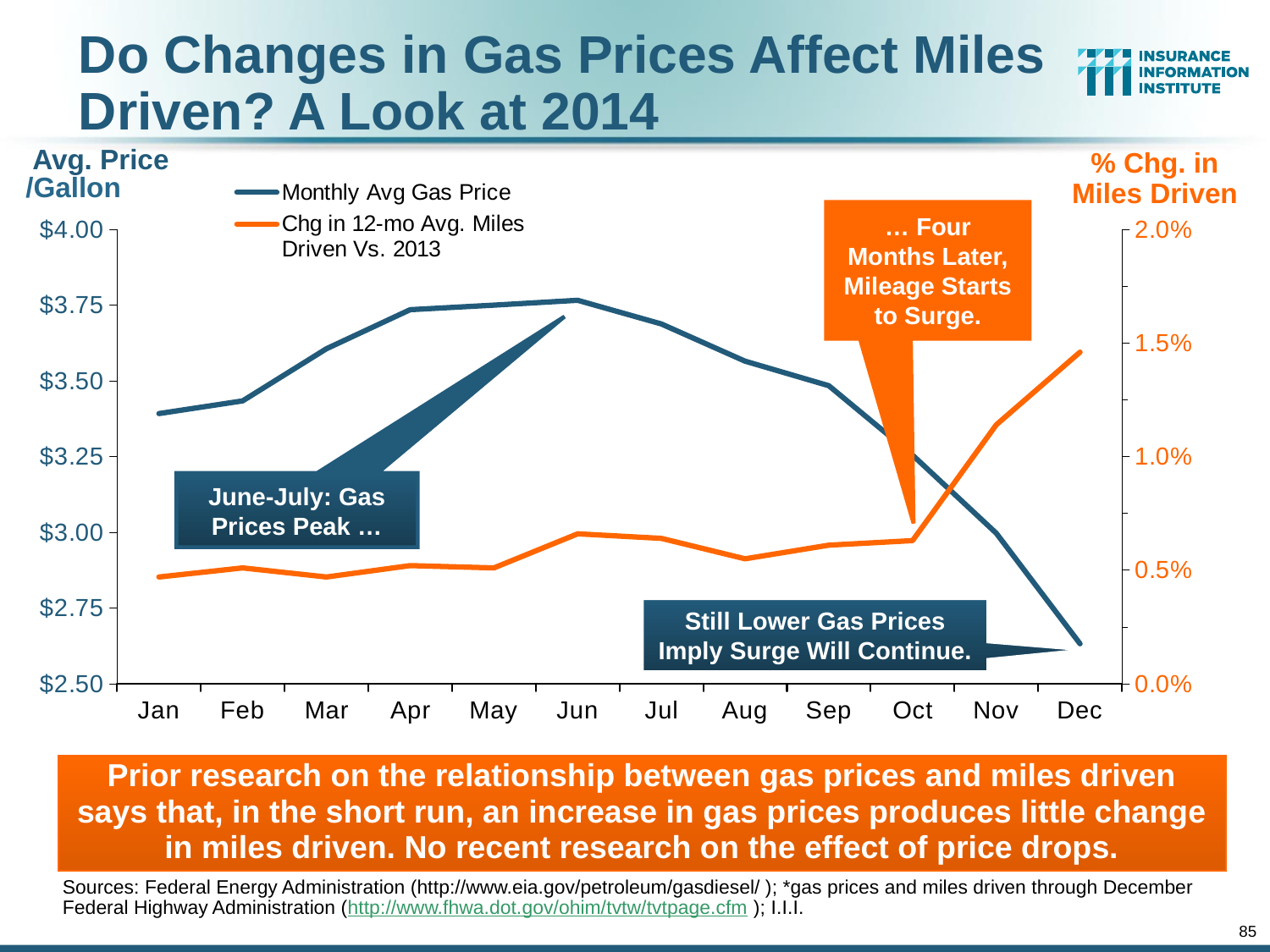
Is the Monthly Avg Gas Price for Jan greater or less than $3.25? greater How many series does the legend list? 2 What is the title of the right-hand vertical axis? % Chg. in Miles Driven How many months are plotted along the x axis? 12 Is the Monthly Avg Gas Price for Dec greater or less than $2.75? less Which month has the lowest Monthly Avg Gas Price? Dec Does the Monthly Avg Gas Price rise or fall from Jun to Dec? Fall Is the Chg in 12-mo Avg. Miles Driven Vs. 2013 for Oct greater or less than 1.0%? less Which month has the highest value for Chg in 12-mo Avg. Miles Driven Vs. 2013? Dec Which is larger, the Monthly Avg Gas Price in Jan or in Dec? Jan What kind of chart is shown on the slide? Line chart